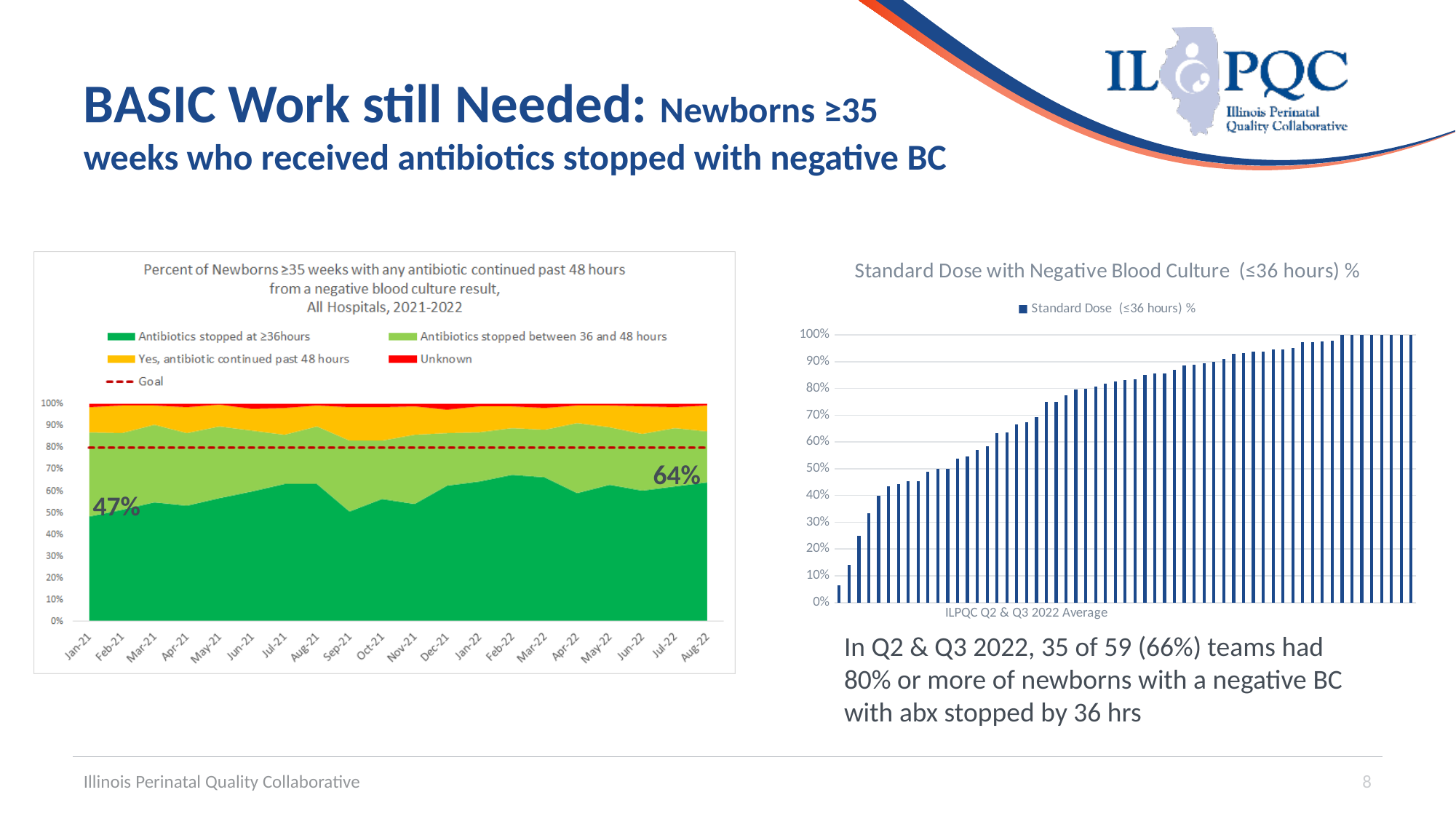
On the left chart, what is the labelled value for antibiotics stopped at ≥36 hours in Aug-22? 64% On the left chart, does the green 'Antibiotics stopped at ≥36 hours' area generally rise or fall from Jan-21 to Aug-22? Rise On the left chart, how many months are shown on the x axis? 20 On the left chart, is the Jan-21 value for antibiotics stopped at ≥36 hours greater or less than 50%? less On the left chart, by how many percentage points did the labelled value for antibiotics stopped at ≥36 hours change from Jan-21 (47%) to Aug-22 (64%)? 17 percentage points What kind of chart is the left chart? Stacked area chart On the left chart, how many entries does the legend list? 5 On the right chart, how many series does the legend list? 1 On the right chart, do the bar values rise or fall from left to right? Rise On the left chart, what is the labelled value for antibiotics stopped at ≥36 hours in Jan-21? 47% What kind of chart is the right chart, 'Standard Dose with Negative Blood Culture (≤36 hours) %'? Bar chart On the left chart, which is larger: the labelled value in Jan-21 or in Aug-22? Aug-22